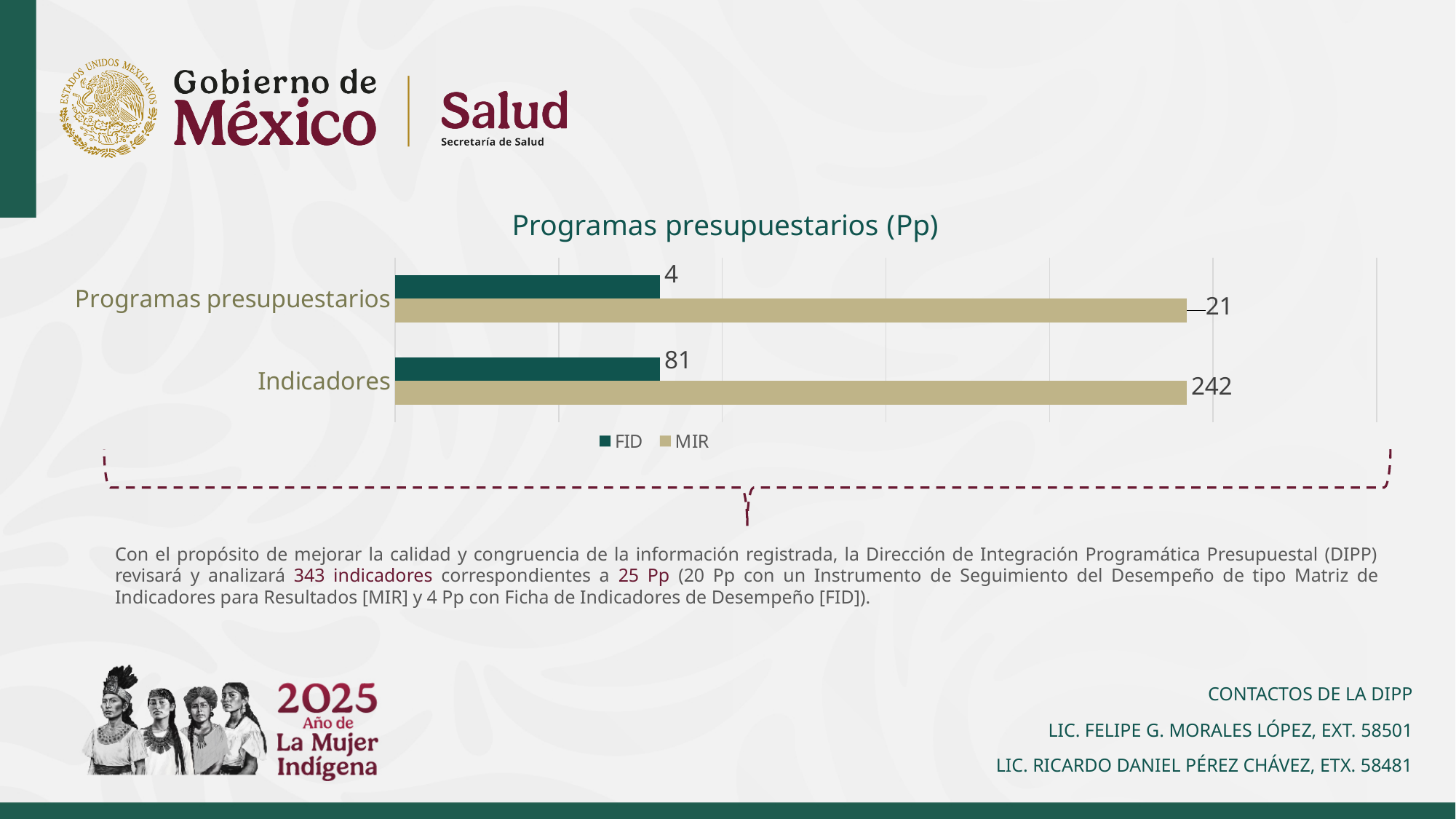
What is the MIR value for Indicadores? 242 Which category has the lowest FID value? Programas presupuestarios What is the difference between the MIR and FID values for Indicadores? 161 What is the FID value for Indicadores? 81 What kind of chart is shown on the slide? Bar chart Which is larger for Indicadores, the FID value or the MIR value? MIR What is the difference between the MIR and FID values for Programas presupuestarios? 17 What is the MIR value for Programas presupuestarios? 21 Which category has the highest MIR value? Indicadores What is the FID value for Programas presupuestarios? 4 How many categories are shown on the chart? 2 How many series does the legend list? 2